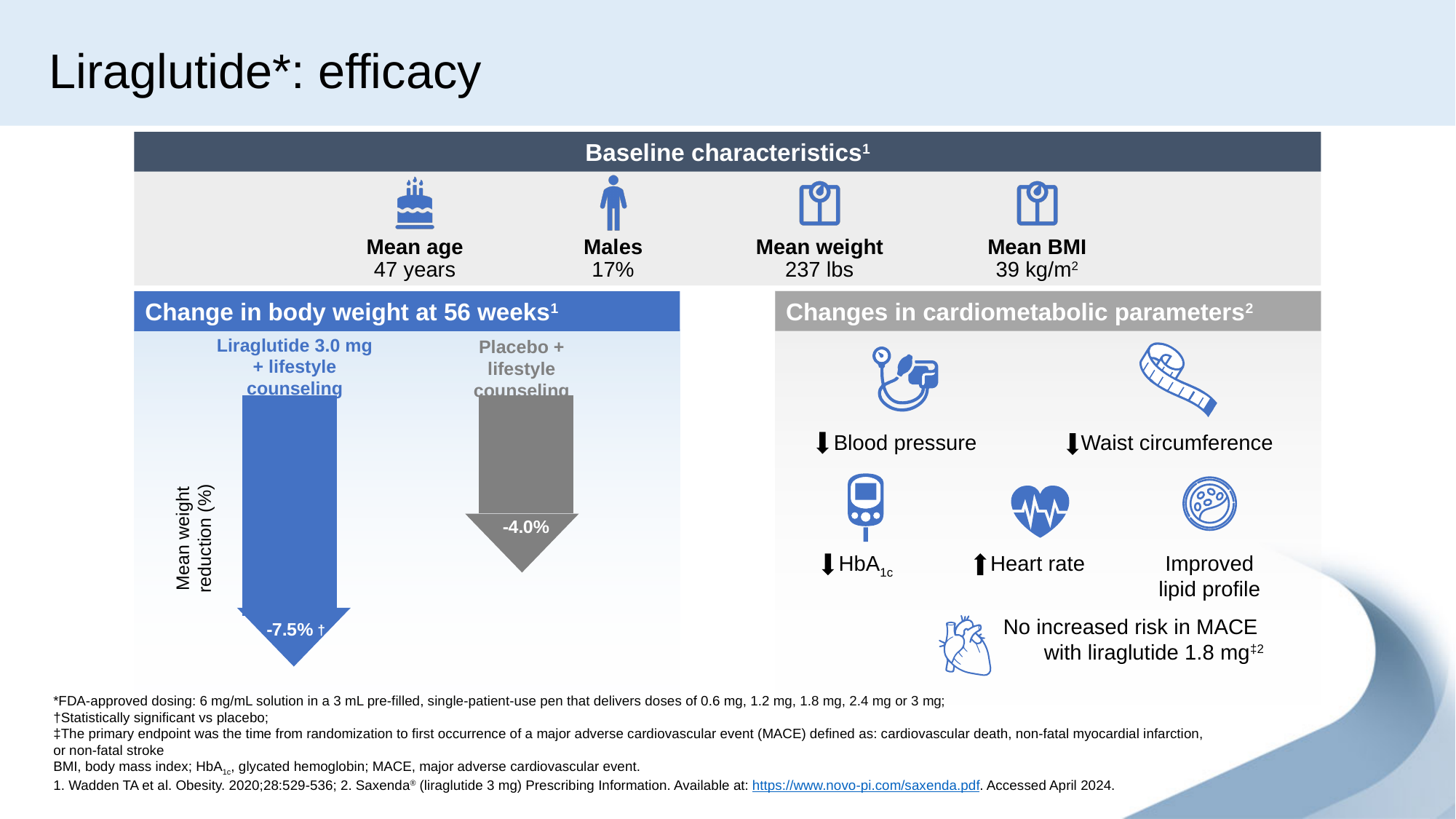
What is the label on the vertical axis of the 'Change in body weight at 56 weeks' chart? Mean weight reduction (%) In the 'Change in body weight at 56 weeks' chart, what is the difference in percentage points between the liraglutide and placebo weight reductions? 3.5 percentage points In the 'Change in body weight at 56 weeks' chart, which group's value is marked with a dagger (†) indicating statistical significance vs placebo? Liraglutide 3.0 mg + lifestyle counseling In the 'Change in body weight at 56 weeks' chart, is the placebo group's weight reduction greater or less than 5%? less In the 'Change in body weight at 56 weeks' chart, what is the mean weight reduction for Placebo + lifestyle counseling? -4.0% In the 'Change in body weight at 56 weeks' chart, is the liraglutide group's weight reduction greater or less than 5%? greater In the 'Change in body weight at 56 weeks' chart, is the weight reduction greater for the liraglutide group or the placebo group? Liraglutide group In the 'Change in body weight at 56 weeks' chart, which group shows the larger mean weight reduction? Liraglutide 3.0 mg + lifestyle counseling In the 'Change in body weight at 56 weeks' chart, what is the mean weight reduction for Liraglutide 3.0 mg + lifestyle counseling? -7.5% In the 'Change in body weight at 56 weeks' chart, which group shows the smaller mean weight reduction? Placebo + lifestyle counseling How many treatment groups are shown in the 'Change in body weight at 56 weeks' chart? 2